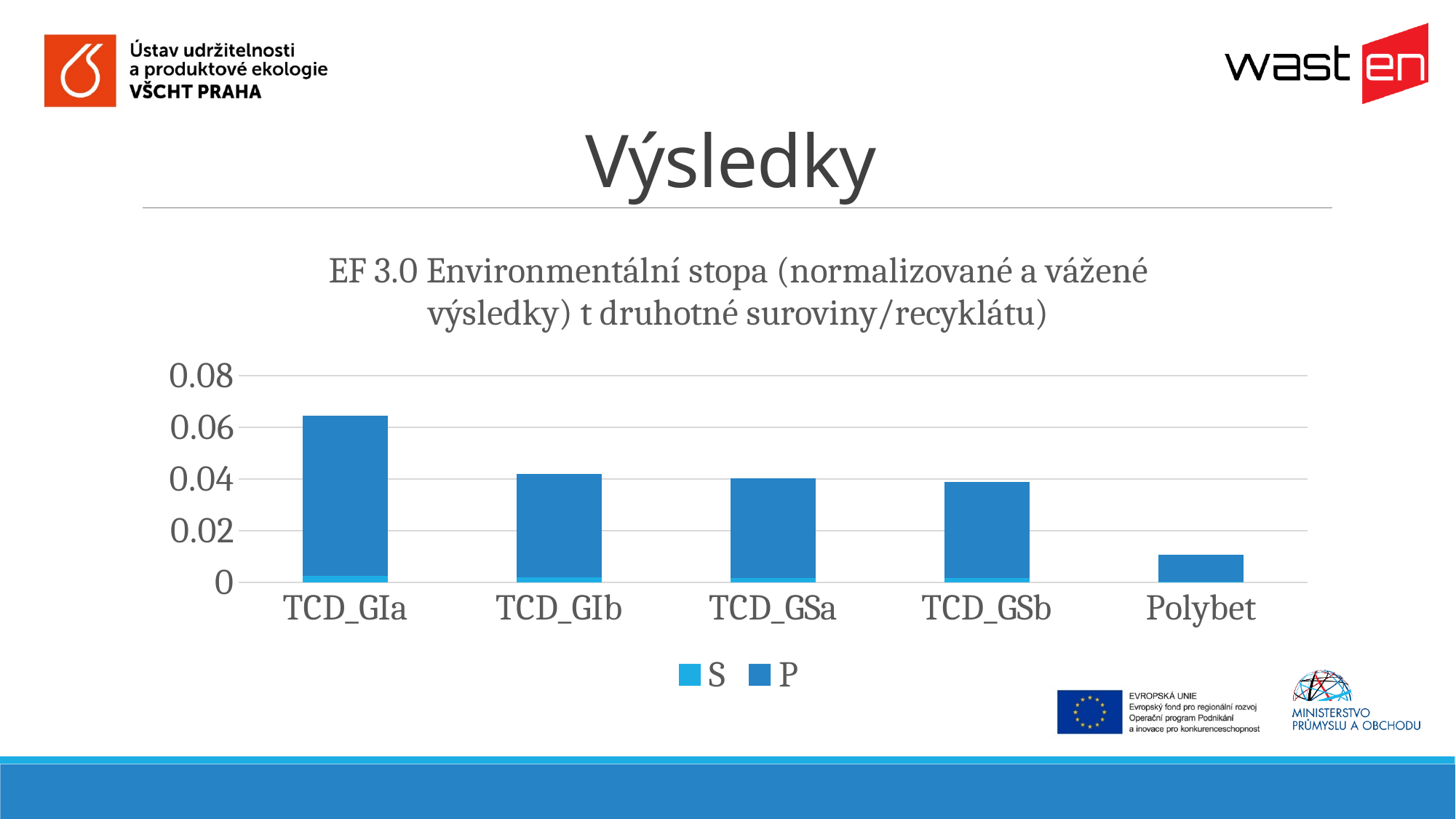
Is the total value for TCD_GIb greater or less than 0.02? greater Which has the larger total bar, TCD_GIa or TCD_GIb? TCD_GIa Which category has the lowest total bar in the chart? Polybet What are the two series names listed in the chart legend? S and P Is the total value for TCD_GIa greater or less than 0.08? less How many categories are shown on the x axis of the chart? 5 Is the total value for Polybet greater or less than 0.02? less How many series does the chart legend list? 2 Which category has the highest total bar in the chart? TCD_GIa What kind of chart is shown on the slide? bar chart Do the total bar values rise or fall from left to right along the x axis? fall